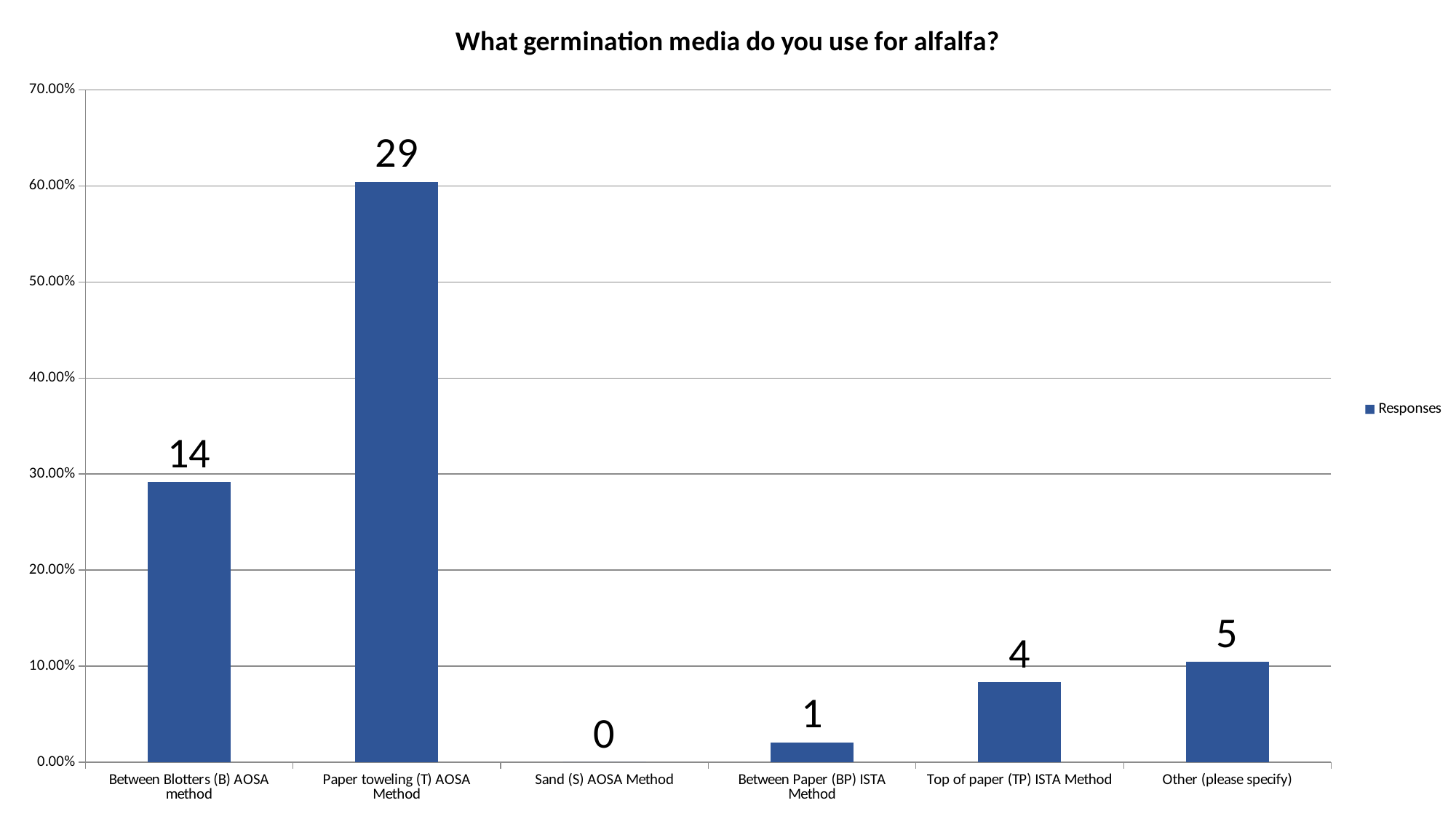
Which has a larger value, Top of paper (TP) ISTA Method or Other (please specify)? Other (please specify) Is the value for Paper toweling (T) AOSA Method greater or less than 50.00%? greater Which category has the lowest value? Sand (S) AOSA Method How many categories are shown on the x axis? 6 Which category has the highest value? Paper toweling (T) AOSA Method Is the value for Between Blotters (B) AOSA method greater or less than 30.00%? less What is the data label shown for Other (please specify)? 5 What is the data label shown for Between Blotters (B) AOSA method? 14 What is the title of the chart? What germination media do you use for alfalfa? What is the difference between the data labels for Paper toweling (T) AOSA Method and Between Blotters (B) AOSA method? 15 What type of chart is shown? bar chart What is the data label shown for Paper toweling (T) AOSA Method? 29